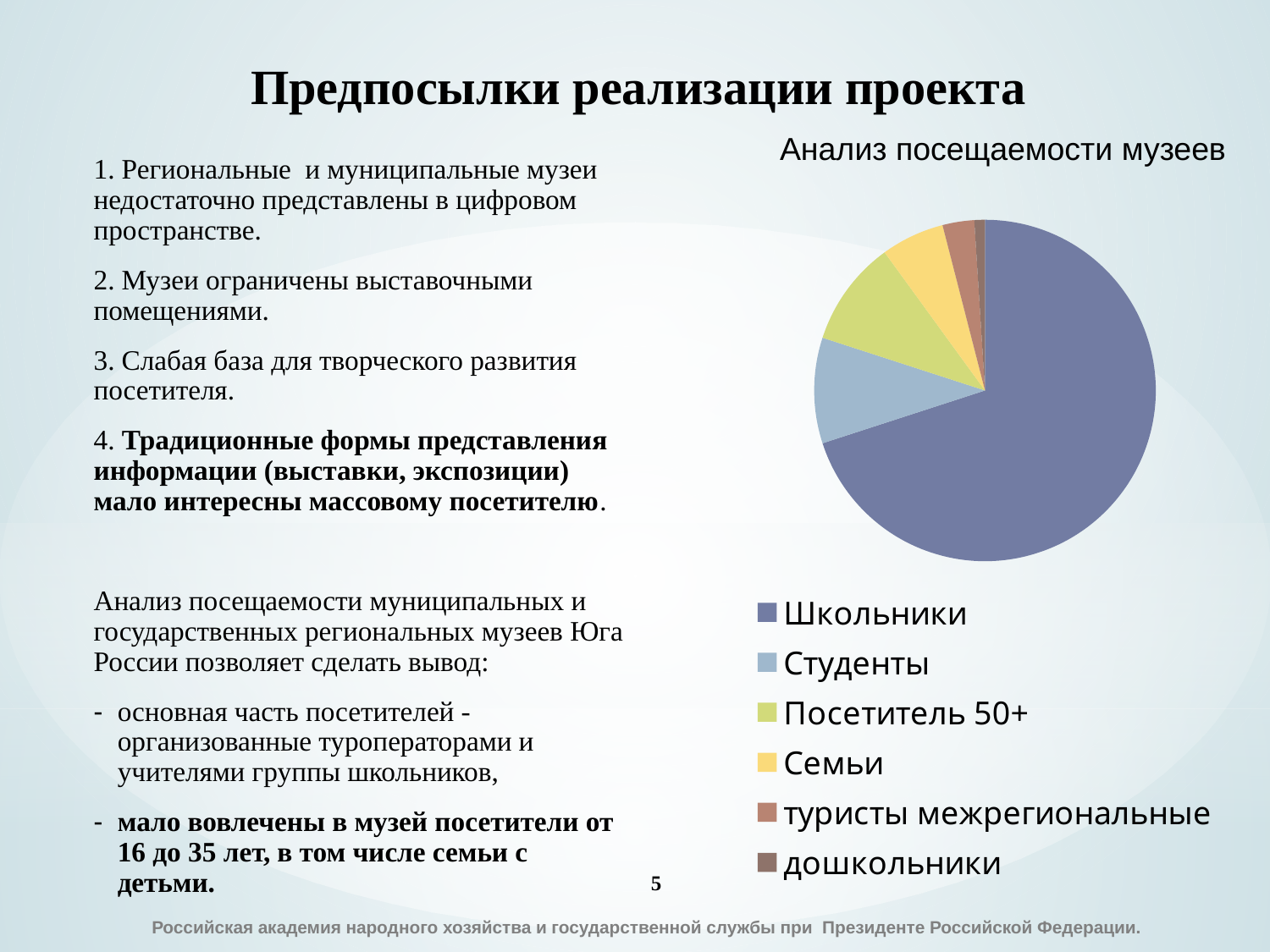
Which slice is larger, Школьники or Студенты? Школьники How many entries does the chart legend list? 6 Which category has the largest slice of the pie chart? Школьники Which slice is larger, Студенты or туристы межрегиональные? Студенты Which category has the smallest slice of the pie chart? дошкольники Which category is listed first in the chart legend? Школьники What kind of chart is shown on the slide? pie chart What is the title of the chart on the slide? Анализ посещаемости музеев How many categories does the pie chart show? 6 Which slice is larger, Семьи or дошкольники? Семьи